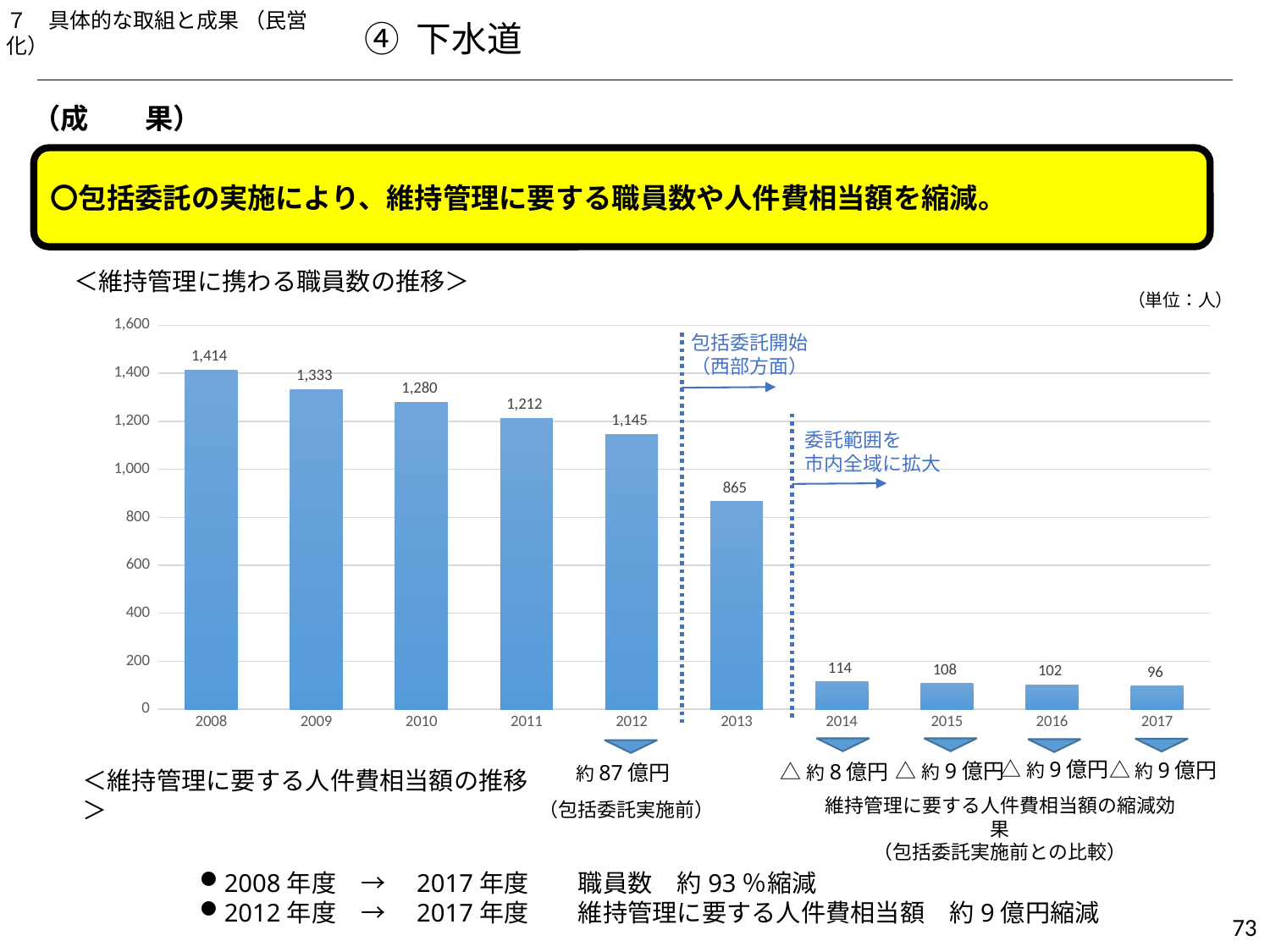
Which year has more staff, 2014 or 2015? 2014 How many years are shown on the x axis of the chart? 10 Which year has the highest number of staff? 2008 Is the value for 2013 greater or less than 1,000? less What is the difference in staff numbers between 2008 and 2017? 1,318 What is the difference in staff numbers between 2012 and 2013? 280 What kind of chart is used to show the staff numbers? bar chart What is the number of staff shown for 2017? 96 What is the number of staff shown for 2013? 865 Do the staff numbers rise or fall from 2008 to 2017? fall Which year has the lowest number of staff? 2017 What is the number of staff shown for 2008? 1,414